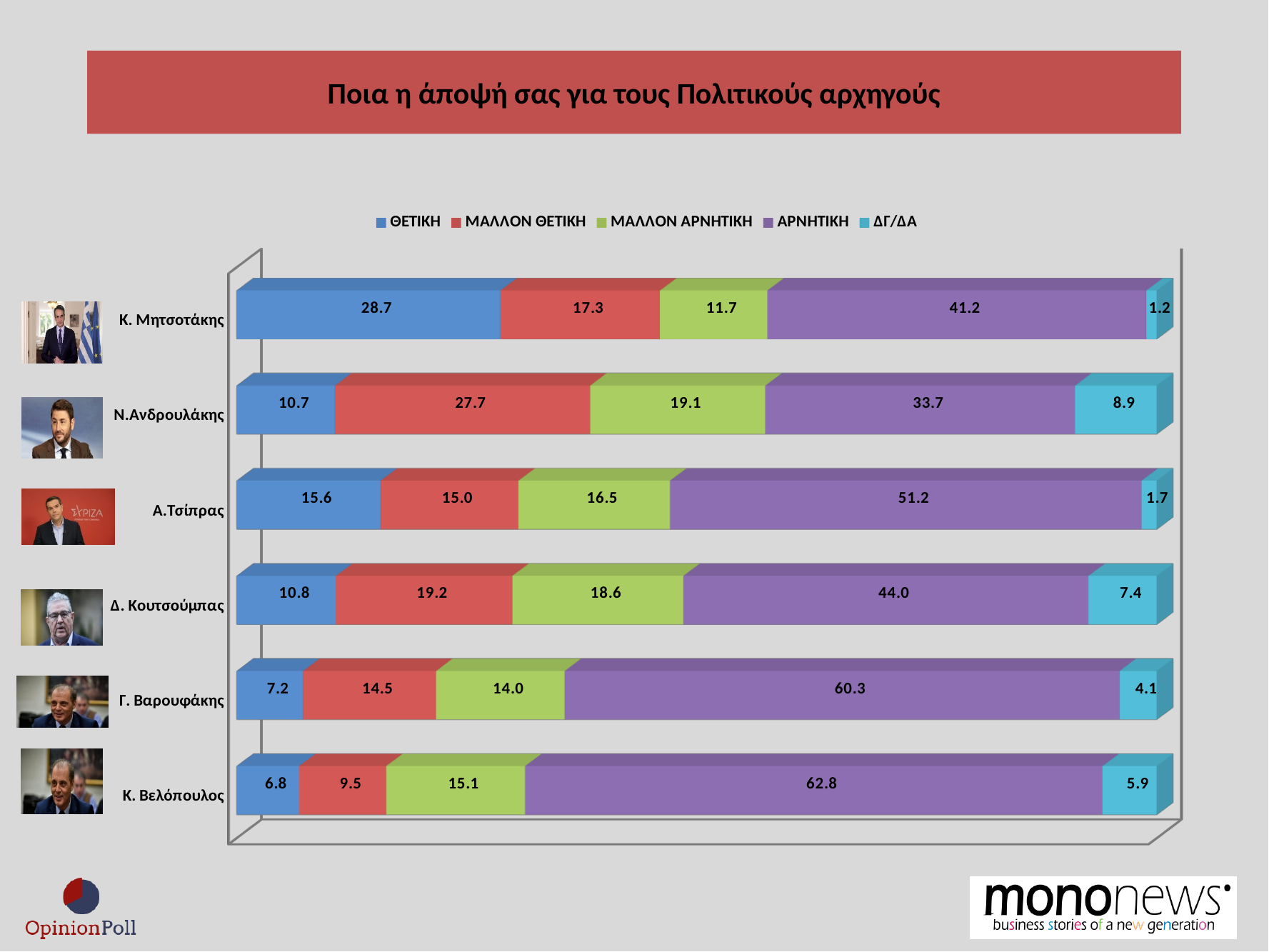
What is the difference between the ΑΡΝΗΤΙΚΗ values for Κ. Βελόπουλος and Γ. Βαρουφάκης? 2.5 Which politician has the highest ΘΕΤΙΚΗ value? Κ. Μητσοτάκης Who has the larger ΜΑΛΛΟΝ ΘΕΤΙΚΗ value, Ν.Ανδρουλάκης or Δ. Κουτσούμπας? Ν.Ανδρουλάκης How many series does the legend list? 5 What is the ΘΕΤΙΚΗ value for Κ. Μητσοτάκης? 28.7 What is the total of the stacked bar for Α.Τσίπρας? 100.0 What is the ΑΡΝΗΤΙΚΗ value for Κ. Βελόπουλος? 62.8 Which politician has the lowest ΑΡΝΗΤΙΚΗ value? Ν.Ανδρουλάκης What kind of chart is shown on the slide? Stacked bar chart How many politicians are shown in the chart? 6 Which colour represents ΑΡΝΗΤΙΚΗ in the legend? Purple What is the ΔΓ/ΔΑ value for Ν.Ανδρουλάκης? 8.9